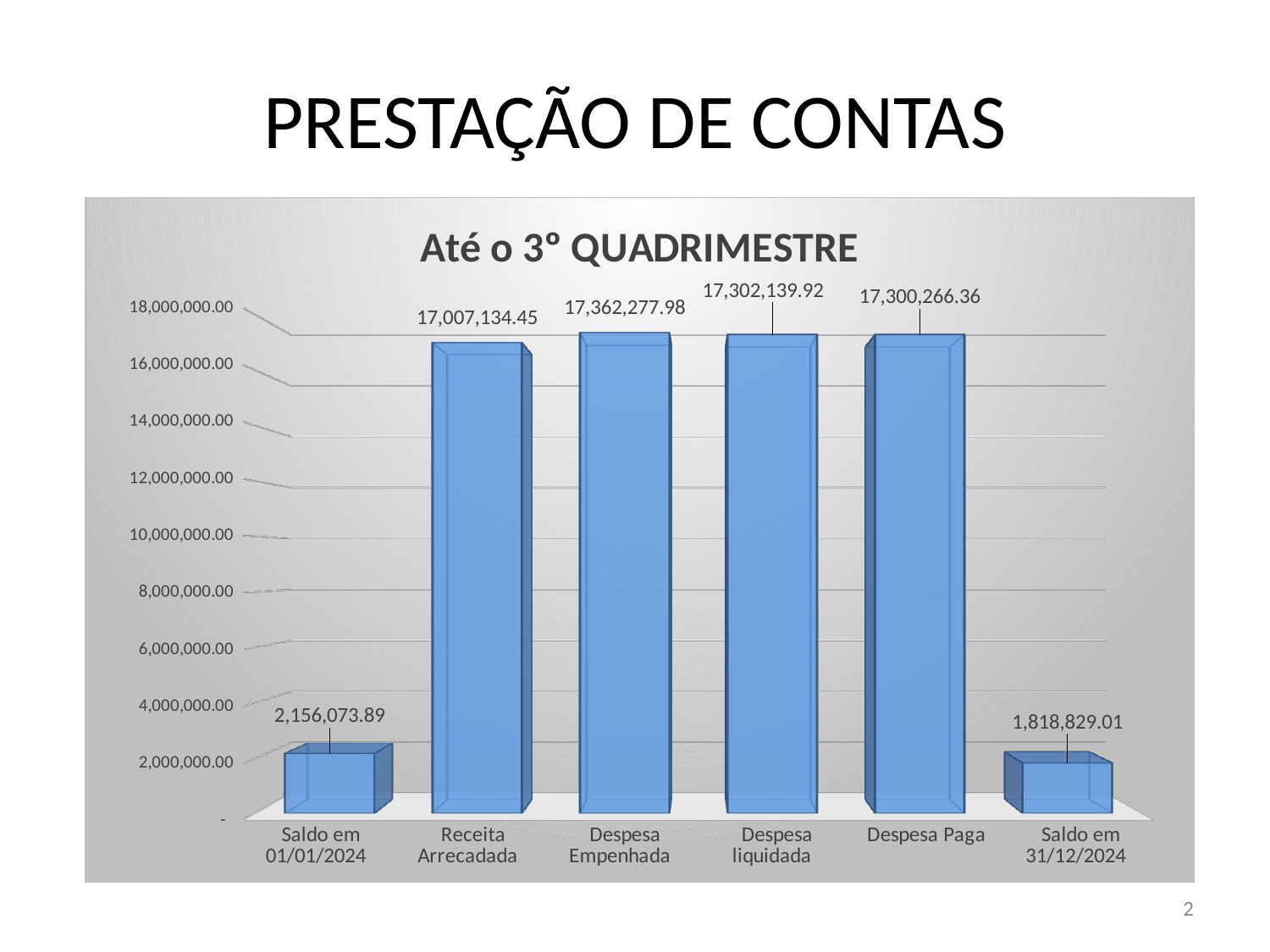
Is the value for Saldo em 01/01/2024 greater or less than 4,000,000.00? less How many categories are shown on the x axis? 6 What is the value for Despesa liquidada? 17,302,139.92 Which category has the highest value? Despesa Empenhada What is the difference between Saldo em 01/01/2024 and Saldo em 31/12/2024? 337,244.88 What is the value for Receita Arrecadada? 17,007,134.45 Which is larger, Receita Arrecadada or Despesa Empenhada? Despesa Empenhada Which category has the lowest value? Saldo em 31/12/2024 What is the title of the chart? Até o 3º QUADRIMESTRE What is the difference between Despesa Empenhada and Despesa Paga? 62,011.62 What kind of chart is shown on the slide? bar chart What is the value for Saldo em 31/12/2024? 1,818,829.01